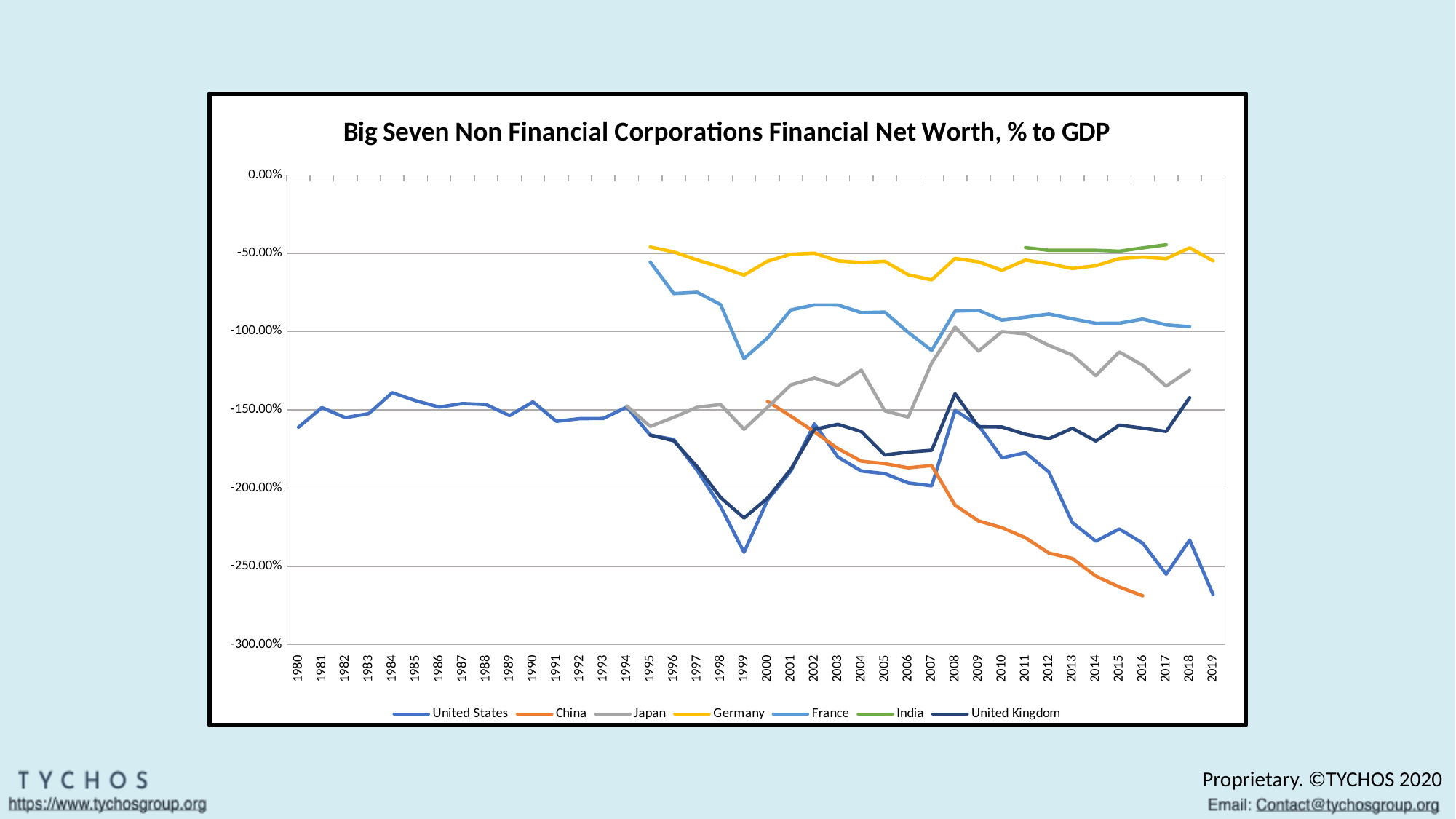
Is the value for United Kingdom in 1999 greater or less than -200.00%? less What kind of chart is shown on the slide? line chart Does the United States series rise or fall from 2008 to 2019? fall In 2019, which is higher, Germany or United States? Germany Which series is drawn in green? India Is the value for Germany in 2007 greater or less than -50.00%? less Is the value for France in 1999 greater or less than -100.00%? less How many years are shown on the x axis? 40 How many series does the legend list? 7 What is the title of the chart? Big Seven Non Financial Corporations Financial Net Worth, % to GDP